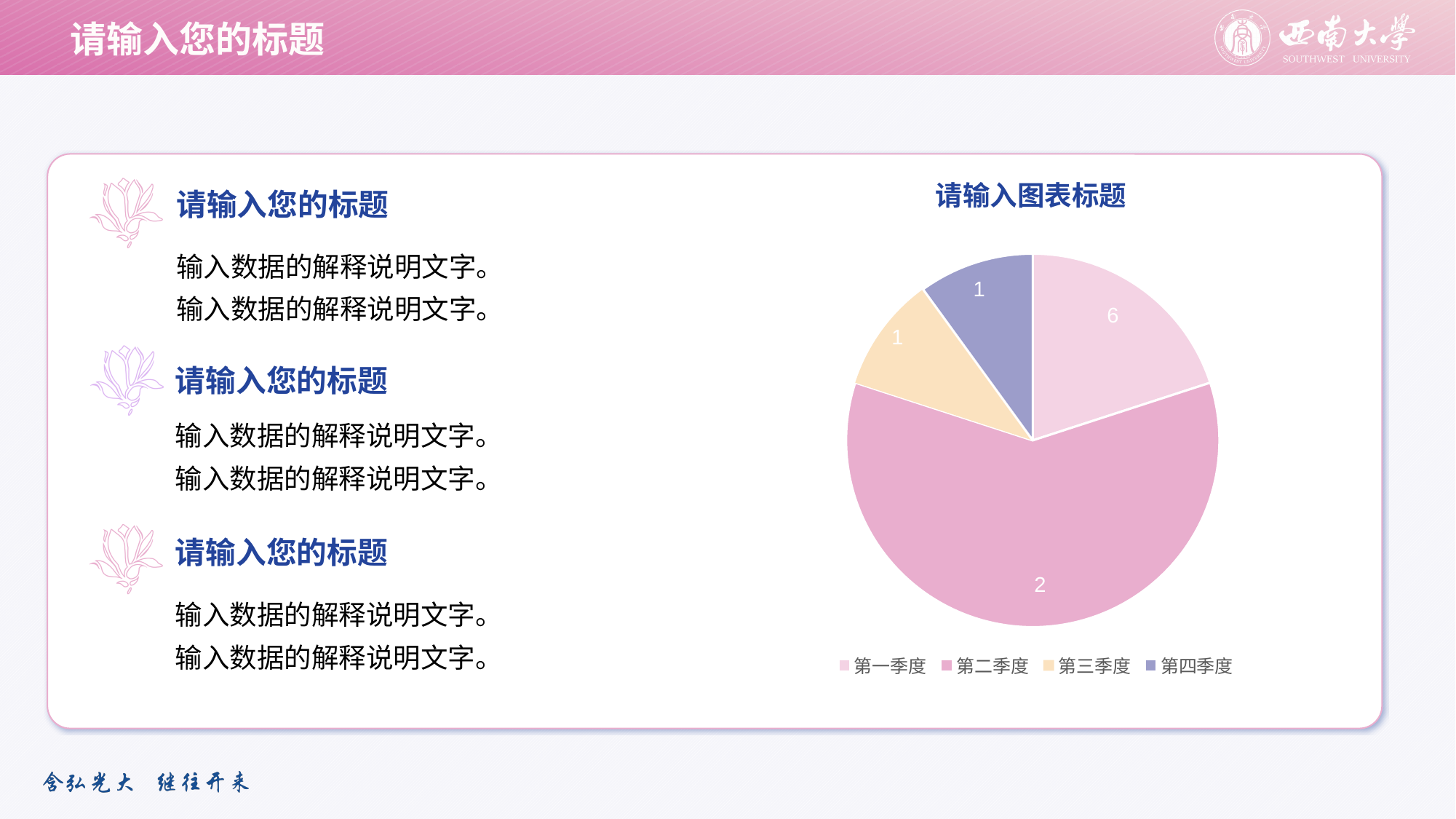
What kind of chart is shown on the slide? pie chart What data label is printed on the 第一季度 slice of the pie chart? 6 How many slices does the pie chart have? 4 How many entries does the legend of the pie chart list? 4 What data label is printed on the 第三季度 slice of the pie chart? 1 Which legend entry is listed first in the pie chart's legend? 第一季度 What data label is printed on the 第四季度 slice of the pie chart? 1 What is the title of the pie chart? 请输入图表标题 What data label is printed on the 第二季度 slice of the pie chart? 2 Which slice of the pie chart takes up the largest area? 第二季度